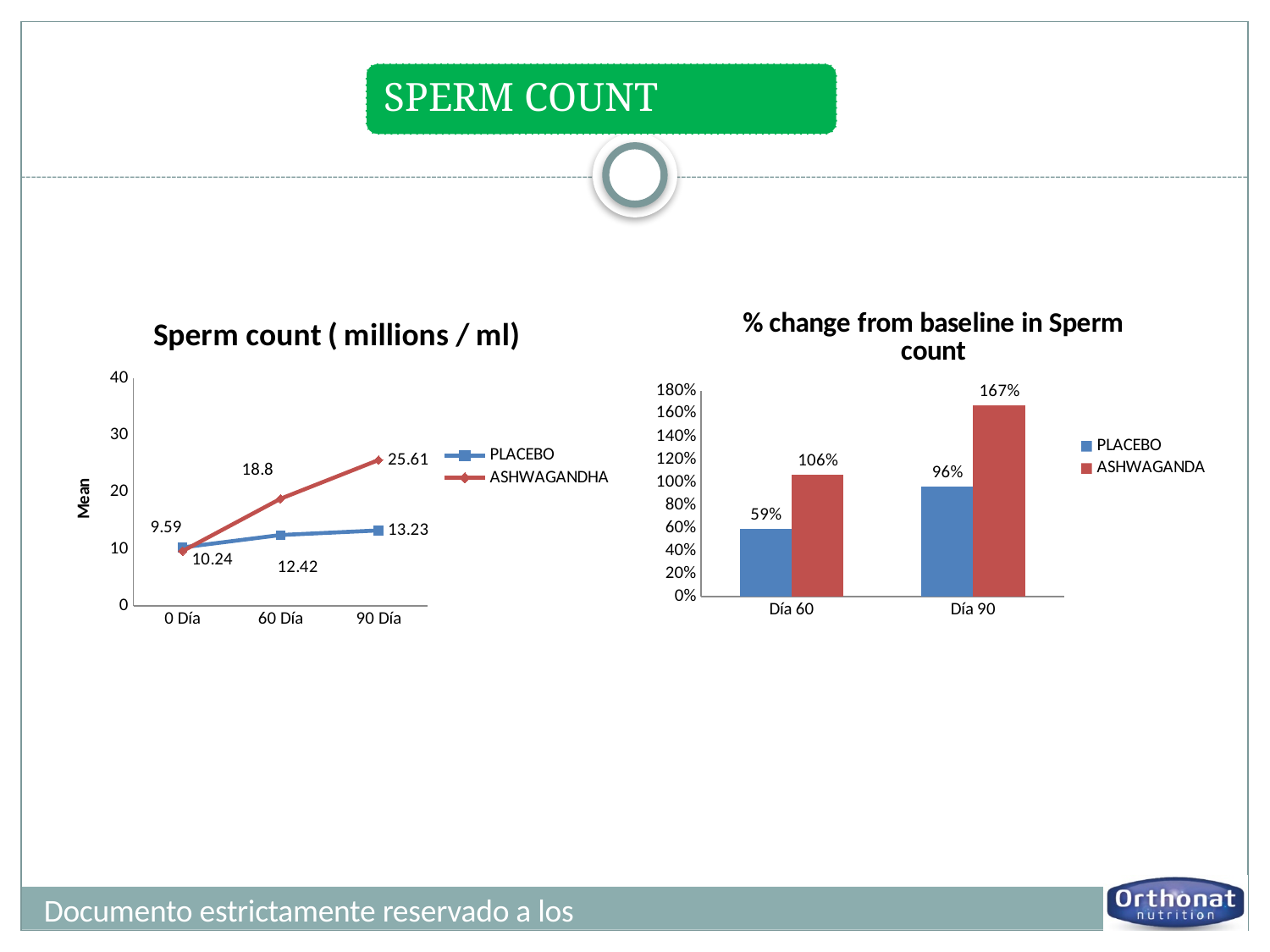
In the 'Sperm count ( millions / ml)' chart, what is the value for PLACEBO at 60 Día? 12.42 In the 'Sperm count ( millions / ml)' chart, how many points are on the x axis? 3 What kind of chart is the 'Sperm count ( millions / ml)' chart? line chart In the '% change from baseline in Sperm count' chart, what is the difference between ASHWAGANDA and PLACEBO at Día 90? 71% In the 'Sperm count ( millions / ml)' chart, does the ASHWAGANDHA line rise or fall from 0 Día to 90 Día? rise What kind of chart is the '% change from baseline in Sperm count' chart? bar chart In the '% change from baseline in Sperm count' chart, what is the value for PLACEBO at Día 60? 59% In the '% change from baseline in Sperm count' chart, how many series does the legend list? 2 In the '% change from baseline in Sperm count' chart, which series has the higher value at Día 60? ASHWAGANDA In the 'Sperm count ( millions / ml)' chart, what is the difference between ASHWAGANDHA and PLACEBO at 90 Día? 12.38 In the '% change from baseline in Sperm count' chart, what is the value for ASHWAGANDA at Día 90? 167% In the 'Sperm count ( millions / ml)' chart, what is the value for ASHWAGANDHA at 90 Día? 25.61